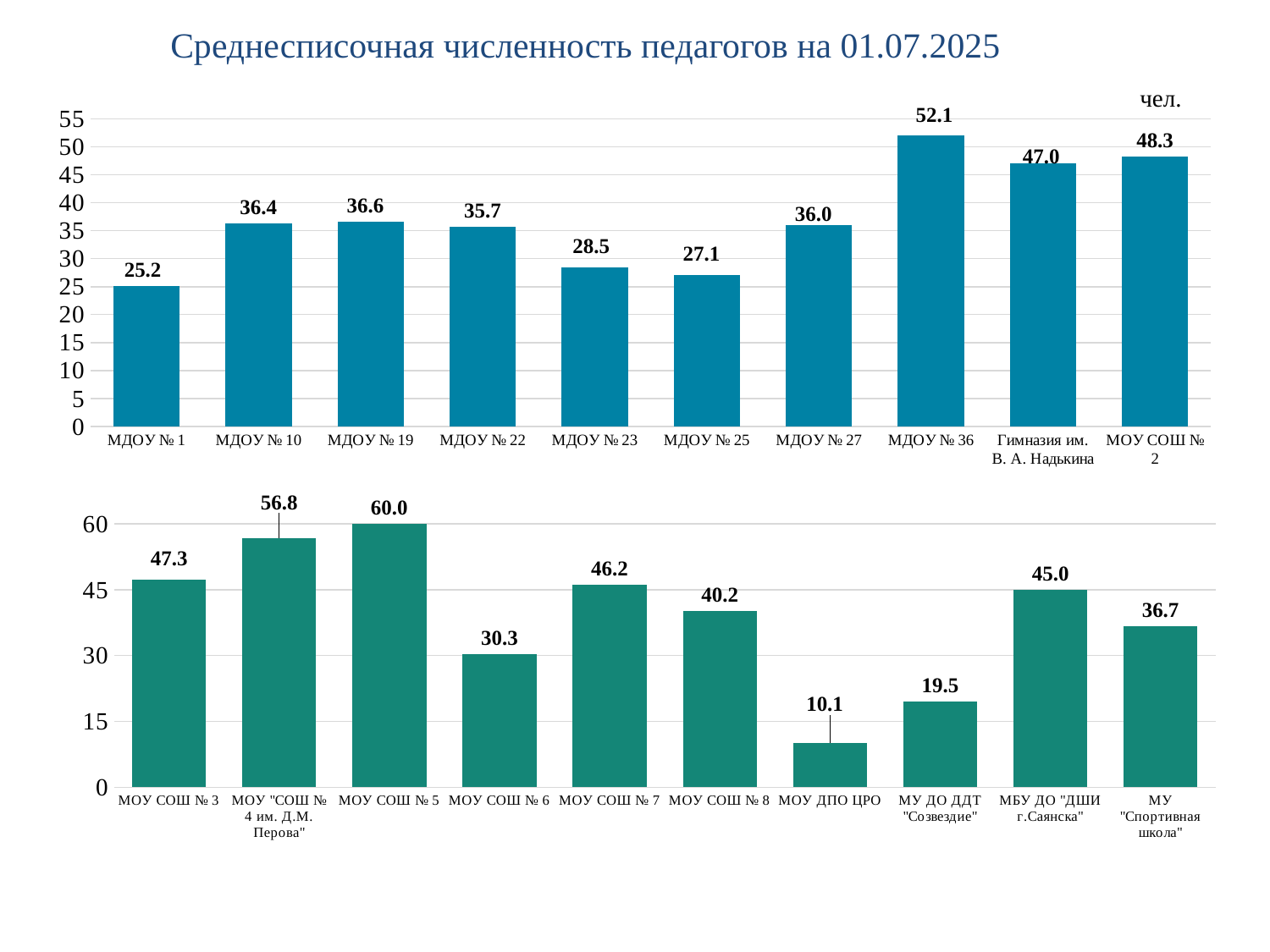
In the top chart, what is the difference between the values for МОУ СОШ № 2 and Гимназия им. В. А. Надькина? 1.3 In the top chart, what is the value for МДОУ № 36? 52.1 In the bottom chart, which category has the lowest value? МОУ ДПО ЦРО What is the title of the top chart? Среднесписочная численность педагогов на 01.07.2025 In the bottom chart, which category has the highest value? МОУ СОШ № 5 In the bottom chart, which is larger: the value for МОУ СОШ № 7 or МОУ СОШ № 8? МОУ СОШ № 7 In the top chart, is the value for МДОУ № 23 greater or less than 30? less How many categories are shown in the bottom chart? 10 In the bottom chart, what is the difference between the values for МОУ СОШ № 5 and МОУ ДПО ЦРО? 49.9 In the top chart, which category has the lowest value? МДОУ № 1 What kind of chart is the top chart? bar chart In the bottom chart, what is the value for МУ ДО ДДТ "Созвездие"? 19.5